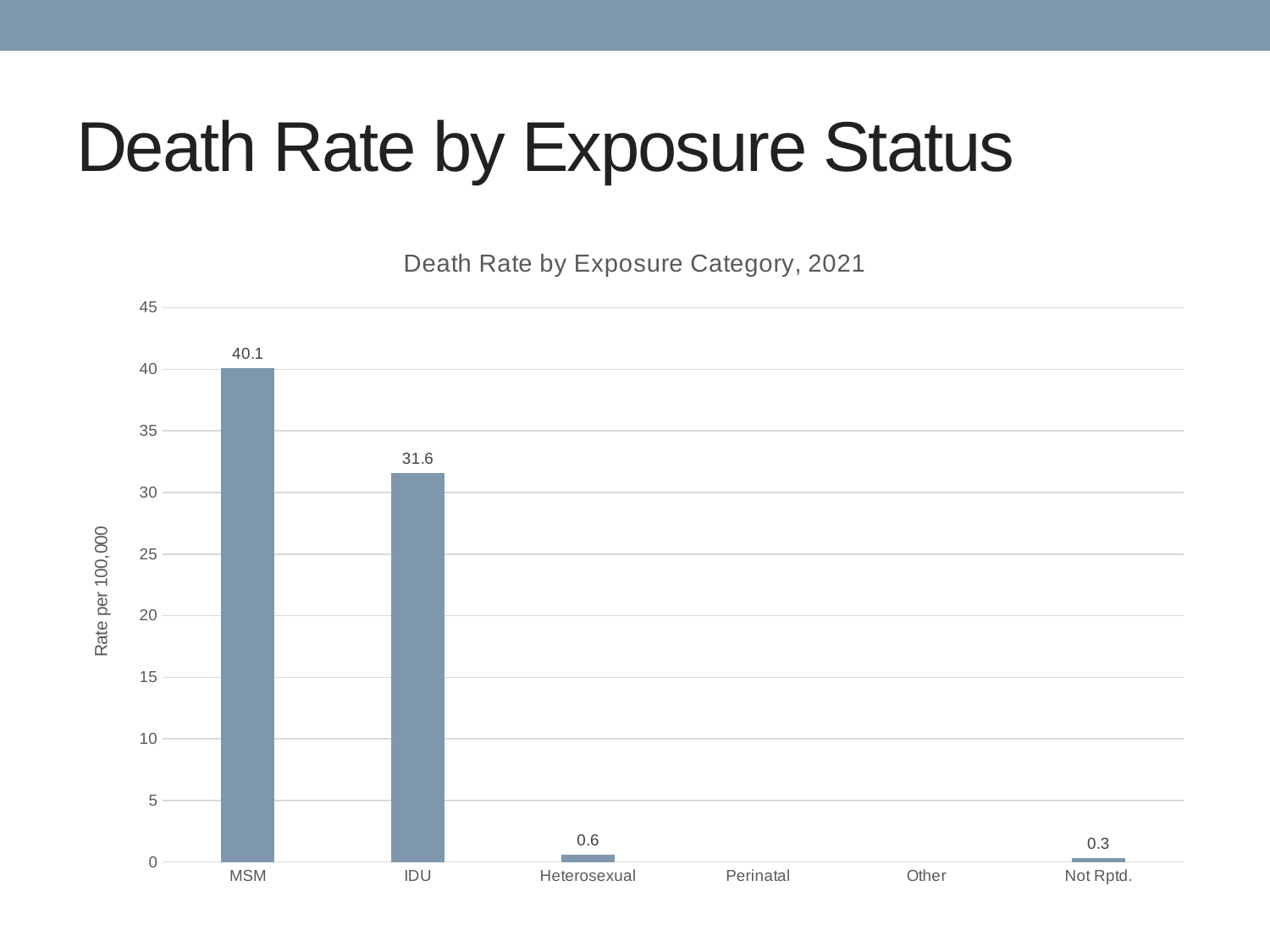
What is the title of the chart? Death Rate by Exposure Category, 2021 What is the death rate per 100,000 for Heterosexual? 0.6 Which exposure category has the highest death rate? MSM What is the difference between the death rates for MSM and IDU? 8.5 What is the label of the vertical axis? Rate per 100,000 What kind of chart is shown on the slide? bar chart What is the death rate per 100,000 for Not Rptd.? 0.3 Which has a higher death rate, Heterosexual or Not Rptd.? Heterosexual What is the death rate per 100,000 for IDU? 31.6 Is the value for IDU greater or less than 30? greater What is the death rate per 100,000 for MSM? 40.1 How many exposure categories are shown on the x axis? 6